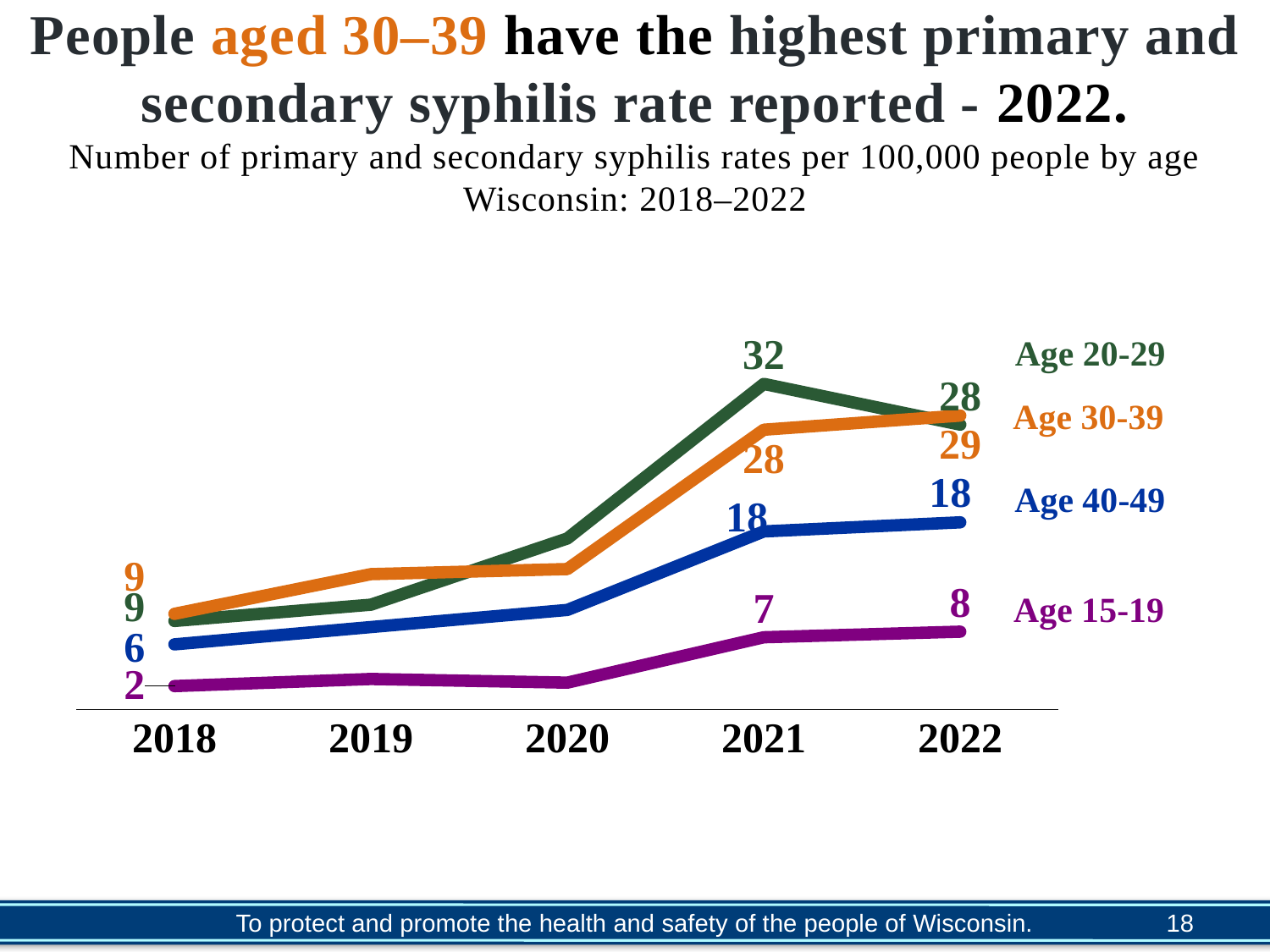
In 2022, which had the higher rate: Age 30-39 or Age 20-29? Age 30-39 What type of chart is shown on the slide? line chart What is the difference between the Age 20-29 rate in 2021 and in 2022? 4 Which age group had the highest rate in 2021? Age 20-29 What was the rate for Age 30-39 in 2022? 29 How many years are shown on the x axis of the chart? 5 Which age group had the lowest rate in 2022? Age 15-19 What was the primary and secondary syphilis rate for Age 20-29 in 2021? 32 What was the rate for Age 15-19 in 2021? 7 Did the rate for Age 40-49 rise or fall from 2018 to 2022? rise How many age groups (series) are plotted on the chart? 4 What was the rate for Age 40-49 in 2018? 6